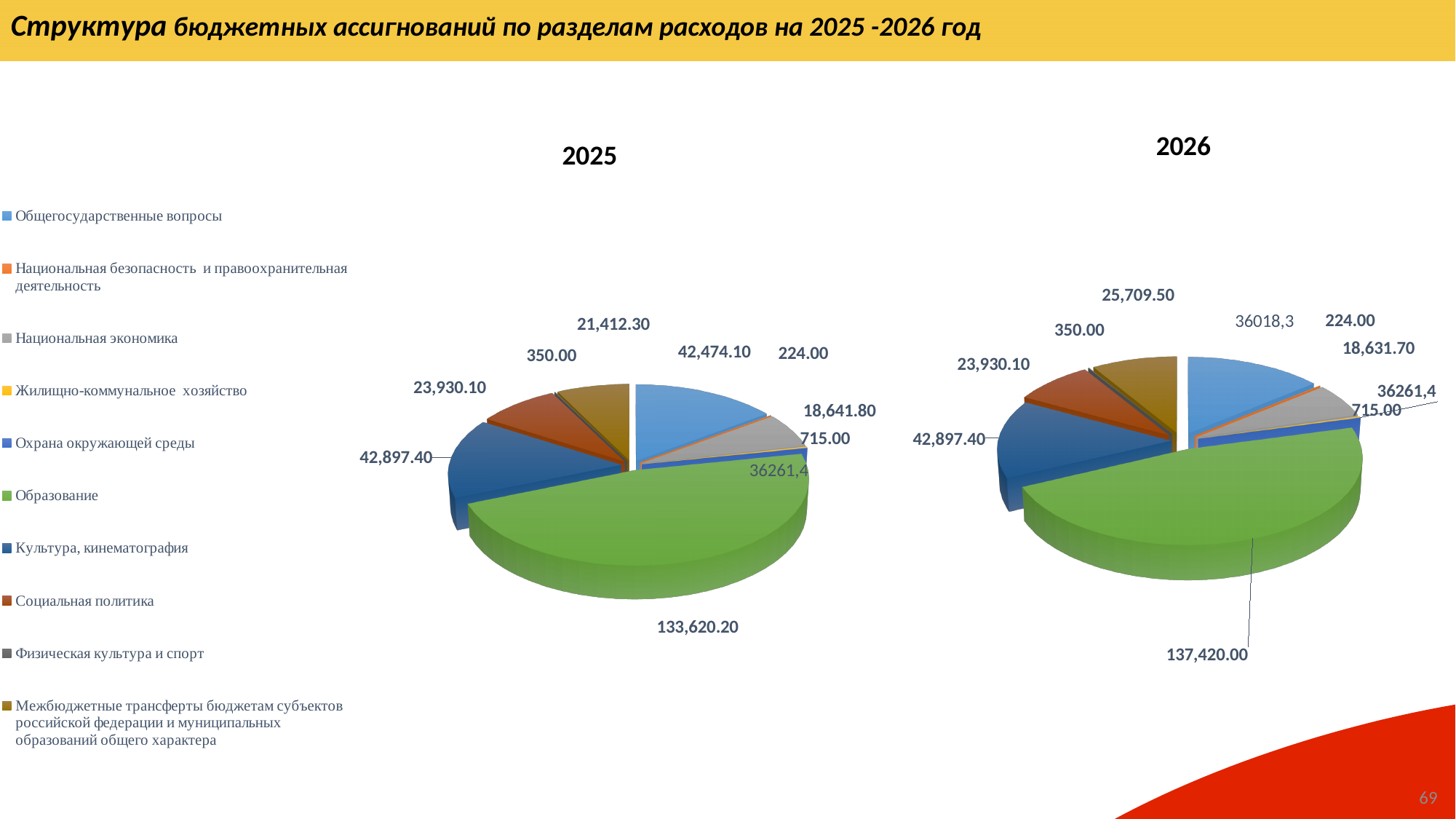
How many categories does the legend list? 10 By how much does the value for Образование in the 2026 chart exceed the value in the 2025 chart? 3,799.80 In the 2026 pie chart, what is the value for Образование? 137,420.00 In the 2026 pie chart, which category has the largest slice? Образование In the 2025 pie chart, which is larger: Образование or Культура, кинематография? Образование In the 2025 pie chart, which category has the largest slice? Образование In the 2025 pie chart, what is the value for Культура, кинематография? 42,897.40 How many pie charts are shown on the slide? 2 In the 2026 pie chart, what is the value for Социальная политика? 23,930.10 What kind of chart is used on this slide for 2025 and 2026? Pie chart In the 2025 pie chart, what is the value for Образование? 133,620.20 What is the title of the pie chart on the right side of the slide? 2026